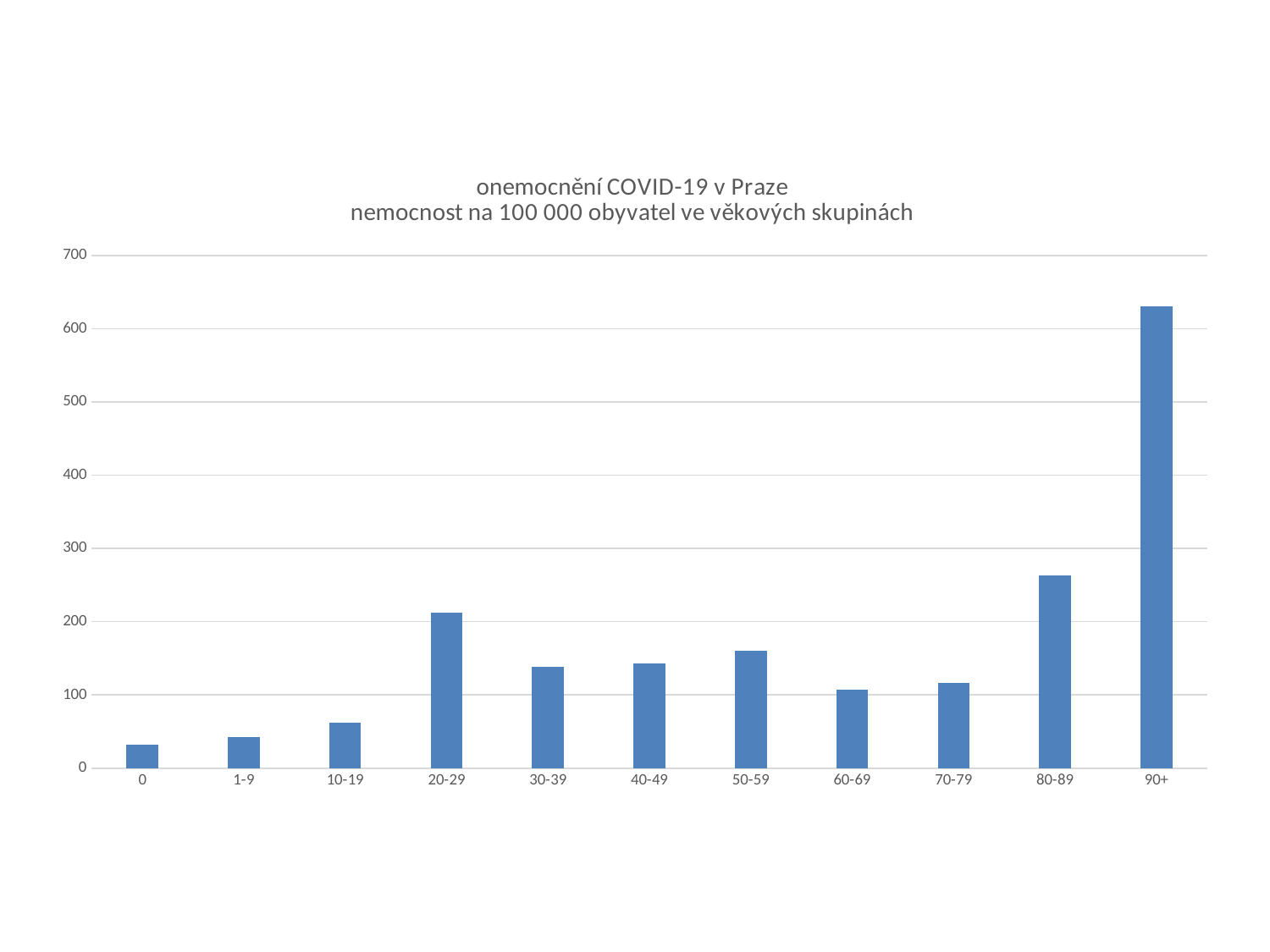
What kind of chart is shown on the slide? bar chart How many age groups are shown on the x axis? 11 Which age group has the lowest value? 0 Is the value for 90+ greater or less than 600? greater Which is larger, the value for 20-29 or the value for 30-39? 20-29 Is the value for 80-89 greater or less than 300? less Which age group has the highest value? 90+ Is the value for 20-29 greater or less than 200? greater Which is larger, the value for 80-89 or the value for 60-69? 80-89 What is the first line of the chart title? onemocnění COVID-19 v Praze